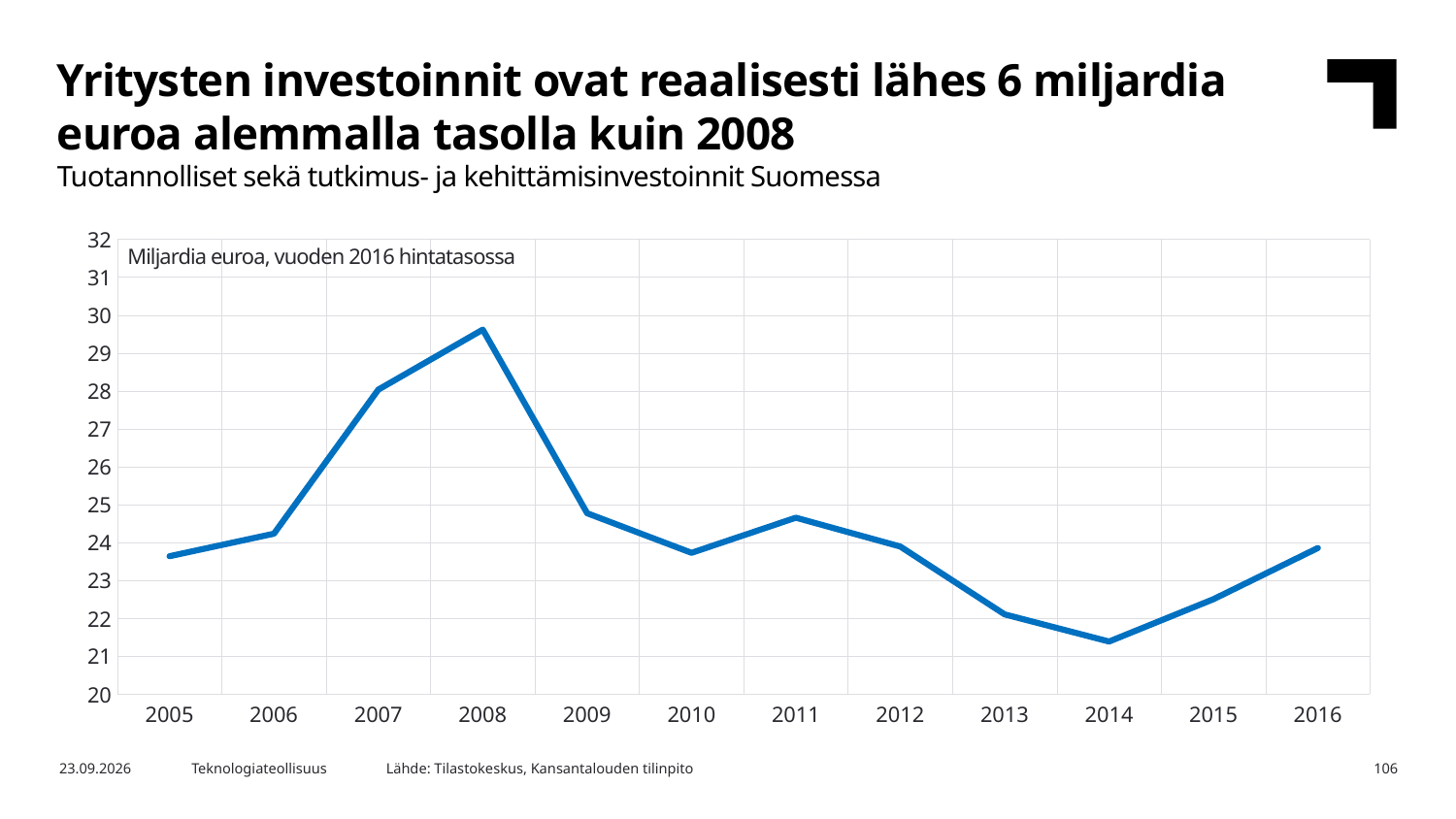
Is the value for 2013 greater or less than 23? less What kind of chart is shown on the slide? line chart Which year has the larger value, 2009 or 2013? 2009 What unit is stated in the label inside the chart area? Miljardia euroa, vuoden 2016 hintatasossa Do the values rise or fall between 2008 and 2010? fall How many years are plotted on the x axis of the chart? 12 Is the value for 2014 greater or less than 22? less In which year does the line reach its lowest value? 2014 Is the value for 2007 greater or less than 27? greater In which year does the line reach its highest value? 2008 Which year has the larger value, 2007 or 2011? 2007